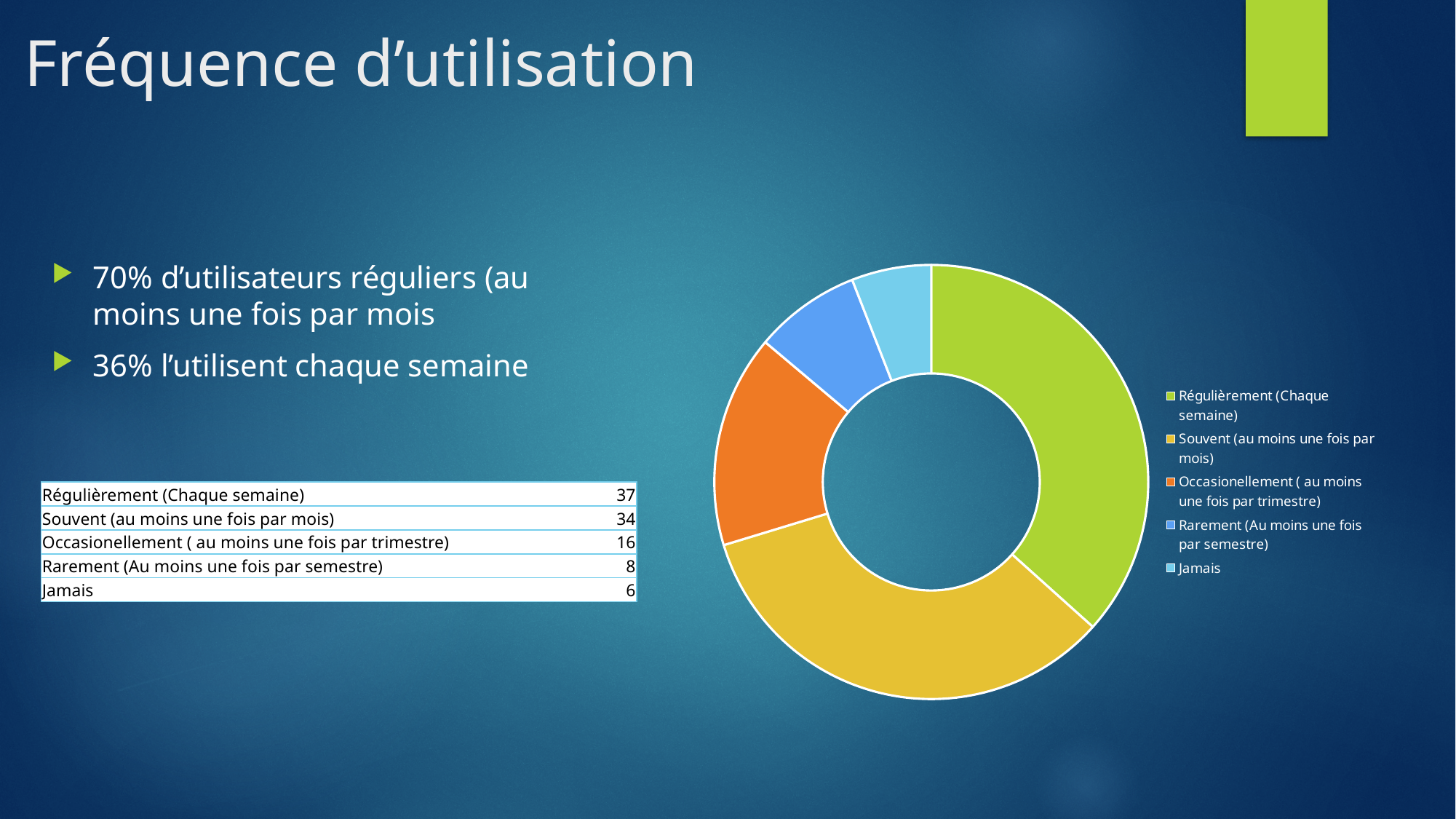
What is the difference between the values for 'Occasionellement ( au moins une fois par trimestre)' and 'Rarement (Au moins une fois par semestre)'? 8 Which is larger, the value for 'Rarement (Au moins une fois par semestre)' or the value for 'Jamais'? Rarement (Au moins une fois par semestre) What kind of chart is shown on the slide? doughnut chart How many categories does the legend of the doughnut chart list? 5 Which category has the smallest slice in the doughnut chart? Jamais What is the value for 'Jamais'? 6 What is the difference between the values for 'Régulièrement (Chaque semaine)' and 'Souvent (au moins une fois par mois)'? 3 What is the value for 'Souvent (au moins une fois par mois)'? 34 What is the value for 'Régulièrement (Chaque semaine)'? 37 Which category has the largest slice in the doughnut chart? Régulièrement (Chaque semaine) What colour is the slice for 'Occasionellement ( au moins une fois par trimestre)' in the doughnut chart? orange What is the value for 'Occasionellement ( au moins une fois par trimestre)'? 16